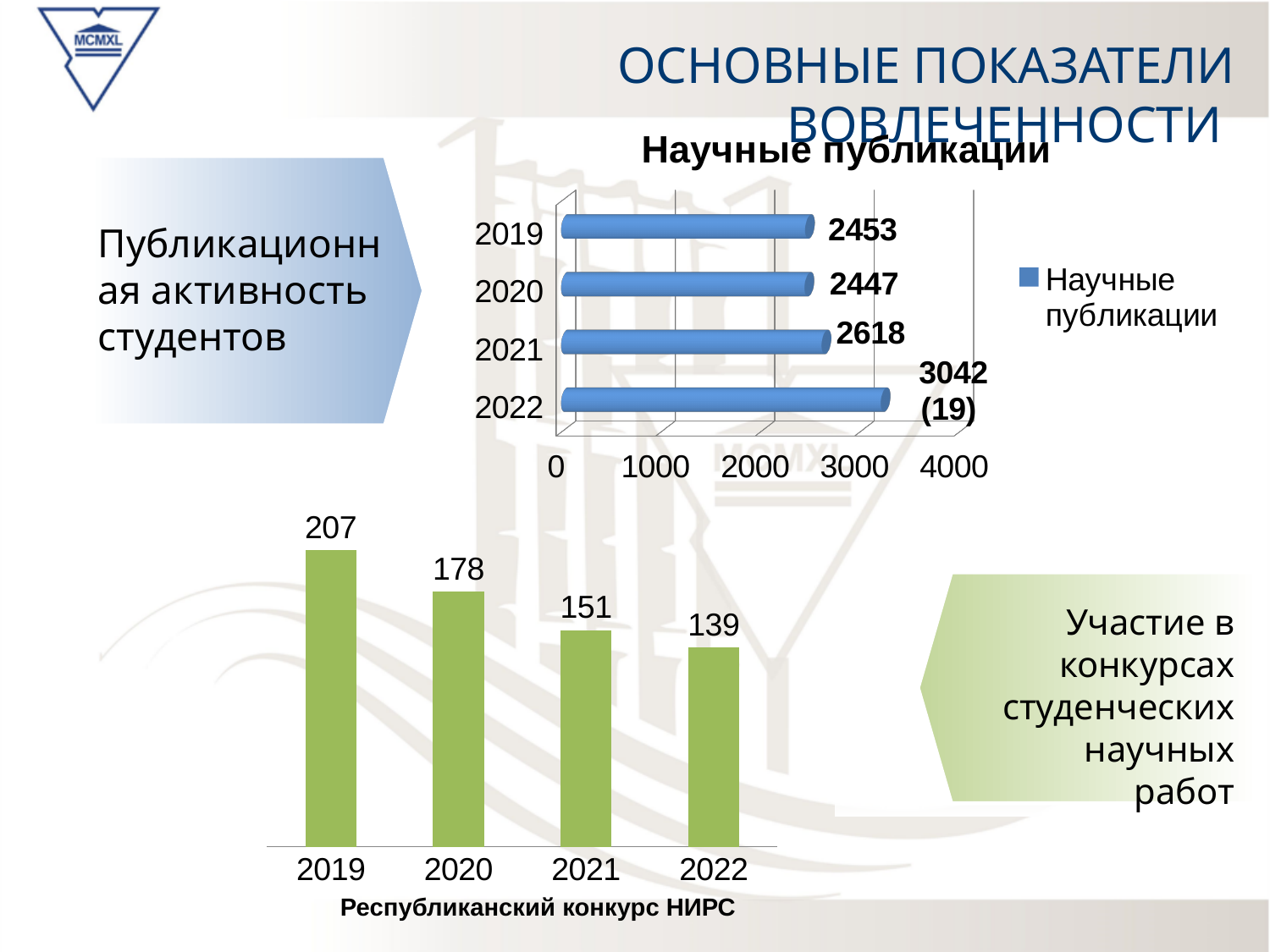
In the chart titled "Республиканский конкурс НИРС", do the values rise or fall from 2019 to 2022? fall In the chart titled "Научные публикации", what is the value for 2019? 2453 In the chart titled "Республиканский конкурс НИРС", which year has the lowest value? 2022 In the chart titled "Научные публикации", which year has the highest value? 2022 What kind of chart is the chart titled "Республиканский конкурс НИРС"? bar chart In the chart titled "Научные публикации", what is the value for 2021? 2618 In the chart titled "Научные публикации", which is larger, the value for 2021 or the value for 2019? 2021 In the chart titled "Научные публикации", how many series does the legend list? 1 In the chart titled "Научные публикации", what is the difference between the values for 2021 and 2020? 171 In the chart titled "Республиканский конкурс НИРС", what is the value for 2020? 178 In the chart titled "Республиканский конкурс НИРС", what is the difference between the values for 2019 and 2022? 68 In the chart titled "Республиканский конкурс НИРС", which year has the highest value? 2019